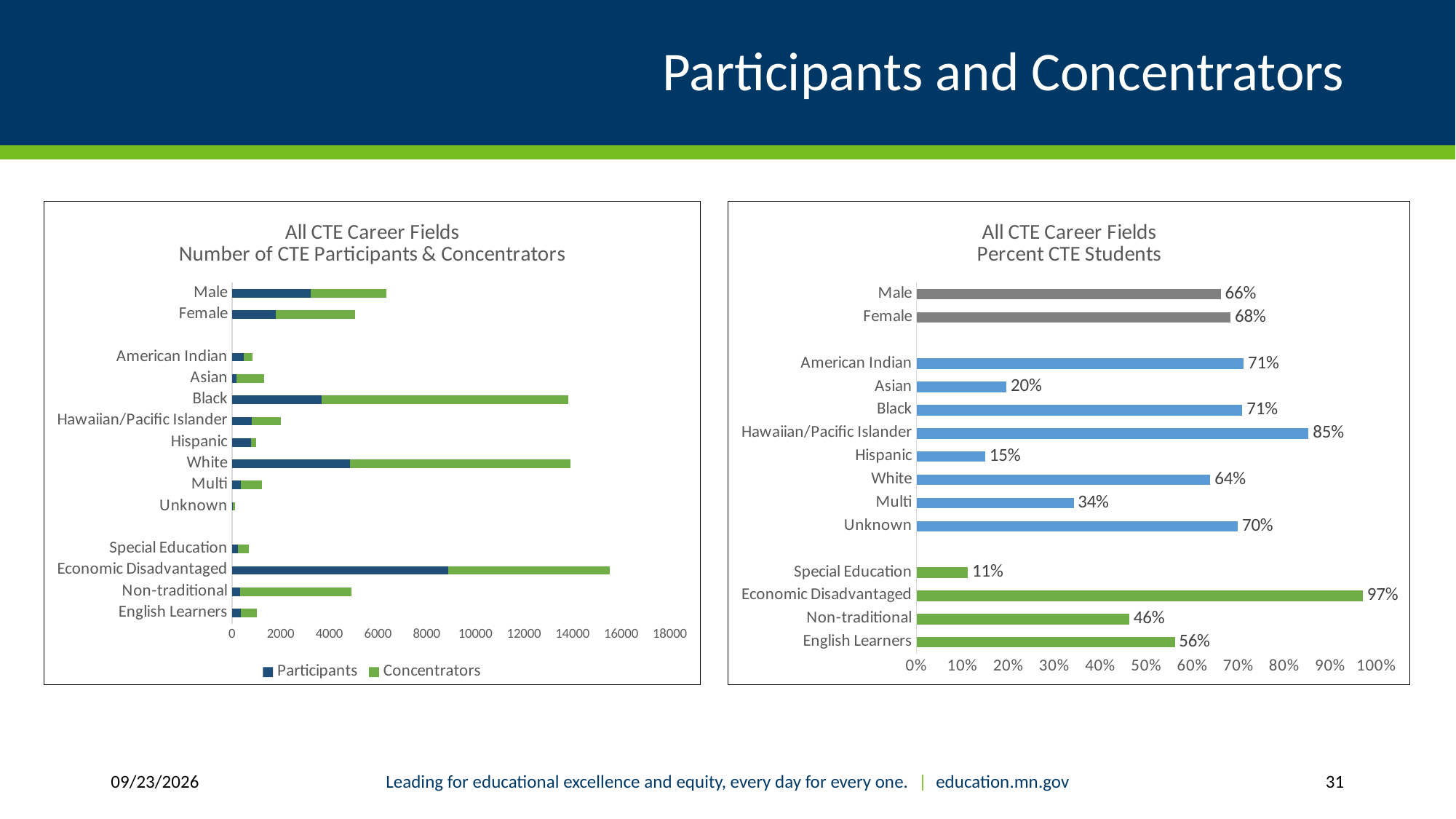
In the 'All CTE Career Fields Number of CTE Participants & Concentrators' chart, how many series does the legend list? 2 In the 'All CTE Career Fields Number of CTE Participants & Concentrators' chart, is the total bar length for Economic Disadvantaged greater or less than 14000? greater In the 'All CTE Career Fields Number of CTE Participants & Concentrators' chart, which has more Participants, Male or Female? Male In the 'All CTE Career Fields Percent CTE Students' chart, what is the difference between the Female and Male values? 2% In the 'All CTE Career Fields Percent CTE Students' chart, which category has the highest value? Economic Disadvantaged In the 'All CTE Career Fields Percent CTE Students' chart, which is larger, the value for Multi or the value for Non-traditional? Non-traditional In the 'All CTE Career Fields Percent CTE Students' chart, what is the difference between the Economic Disadvantaged and English Learners values? 41% In the 'All CTE Career Fields Percent CTE Students' chart, what is the value for Hawaiian/Pacific Islander? 85% In the 'All CTE Career Fields Percent CTE Students' chart, which category has the lowest value? Special Education What kind of chart is the 'All CTE Career Fields Percent CTE Students' chart? Bar chart In the 'All CTE Career Fields Percent CTE Students' chart, what is the value for Hispanic? 15% In the 'All CTE Career Fields Number of CTE Participants & Concentrators' chart, is the total bar length for Asian greater or less than 2000? less